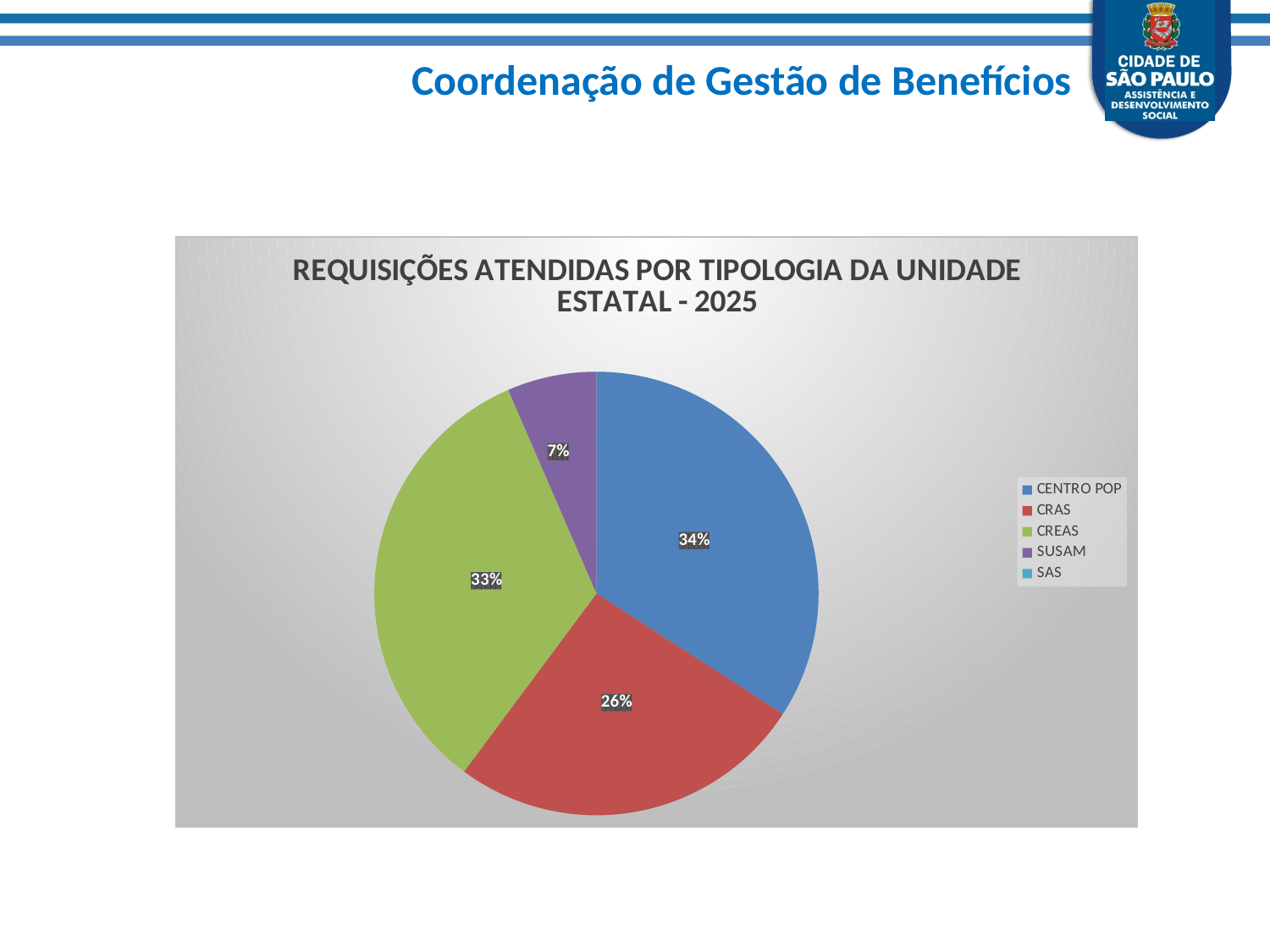
What share of the pie does SUSAM represent? 7% What share of the pie does CENTRO POP represent? 34% What share of the pie does CRAS represent? 26% What colour is the CREAS slice? green How many categories does the legend list? 5 What is the difference in percentage points between the CENTRO POP share and the SUSAM share? 27 Which category has the smallest labelled slice? SUSAM Which category has the largest labelled slice? CENTRO POP What kind of chart is shown on the slide? pie chart Which is larger, the share for CREAS or the share for CRAS? CREAS What is the title of the chart? REQUISIÇÕES ATENDIDAS POR TIPOLOGIA DA UNIDADE ESTATAL - 2025